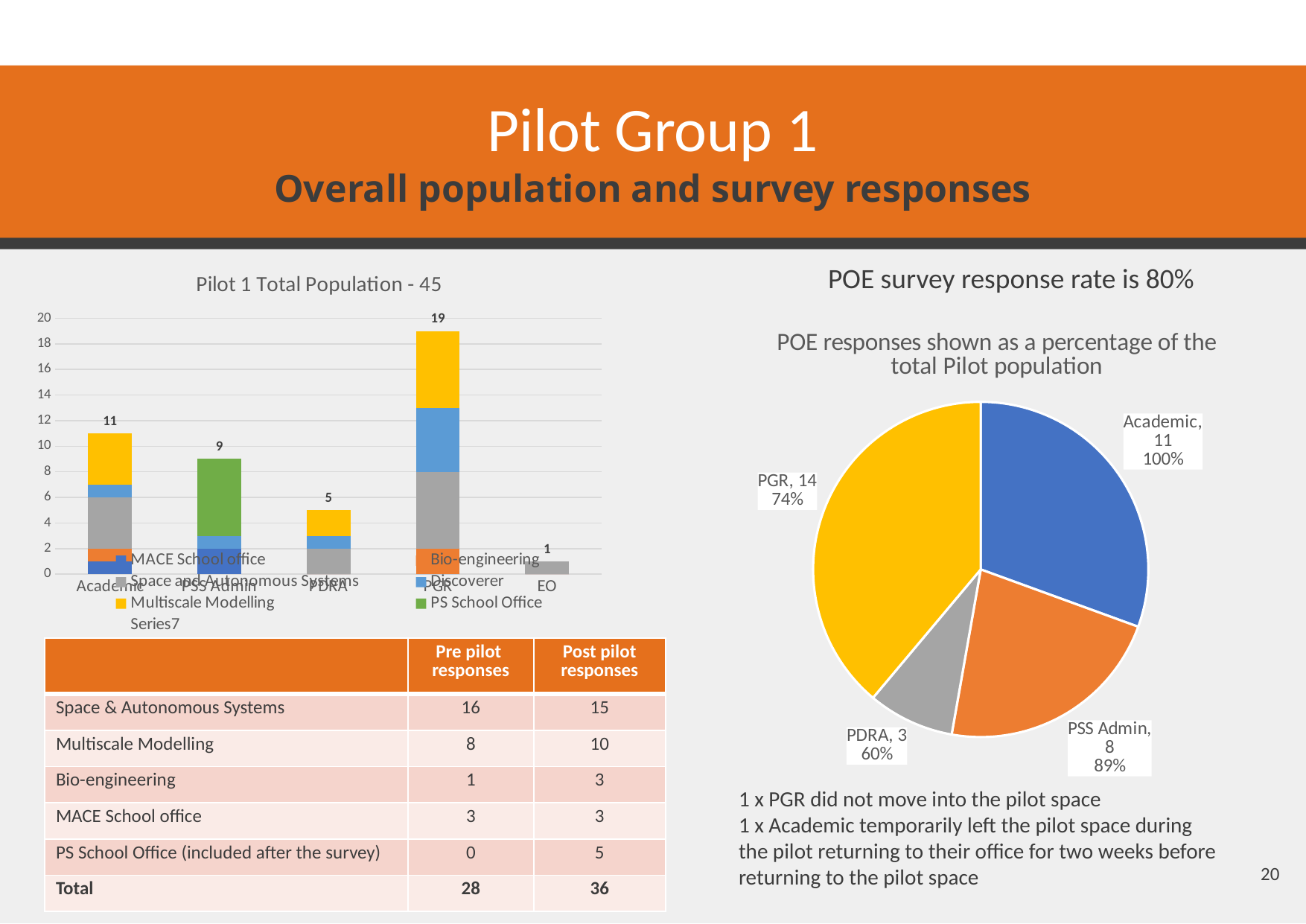
In the pie chart 'POE responses shown as a percentage of the total Pilot population', which slice is the largest? PGR How many slices does the pie chart 'POE responses shown as a percentage of the total Pilot population' have? 4 In the 'Pilot 1 Total Population - 45' bar chart, what is the difference between the totals for PGR and Academic? 8 In the 'Pilot 1 Total Population - 45' bar chart, which category has the highest total? PGR In the pie chart 'POE responses shown as a percentage of the total Pilot population', what percentage is shown for PSS Admin? 89% In the 'Pilot 1 Total Population - 45' bar chart, which category has the lowest total? EO In the 'Pilot 1 Total Population - 45' bar chart, which has the larger total, Academic or PSS Admin? Academic In the 'Pilot 1 Total Population - 45' bar chart, what is the total value shown for PGR? 19 How many categories are shown on the x axis of the 'Pilot 1 Total Population - 45' bar chart? 5 In the pie chart 'POE responses shown as a percentage of the total Pilot population', what value is shown for PGR? 14 How many entries does the legend of the 'Pilot 1 Total Population - 45' chart list? 7 What kind of chart is 'Pilot 1 Total Population - 45'? Bar chart